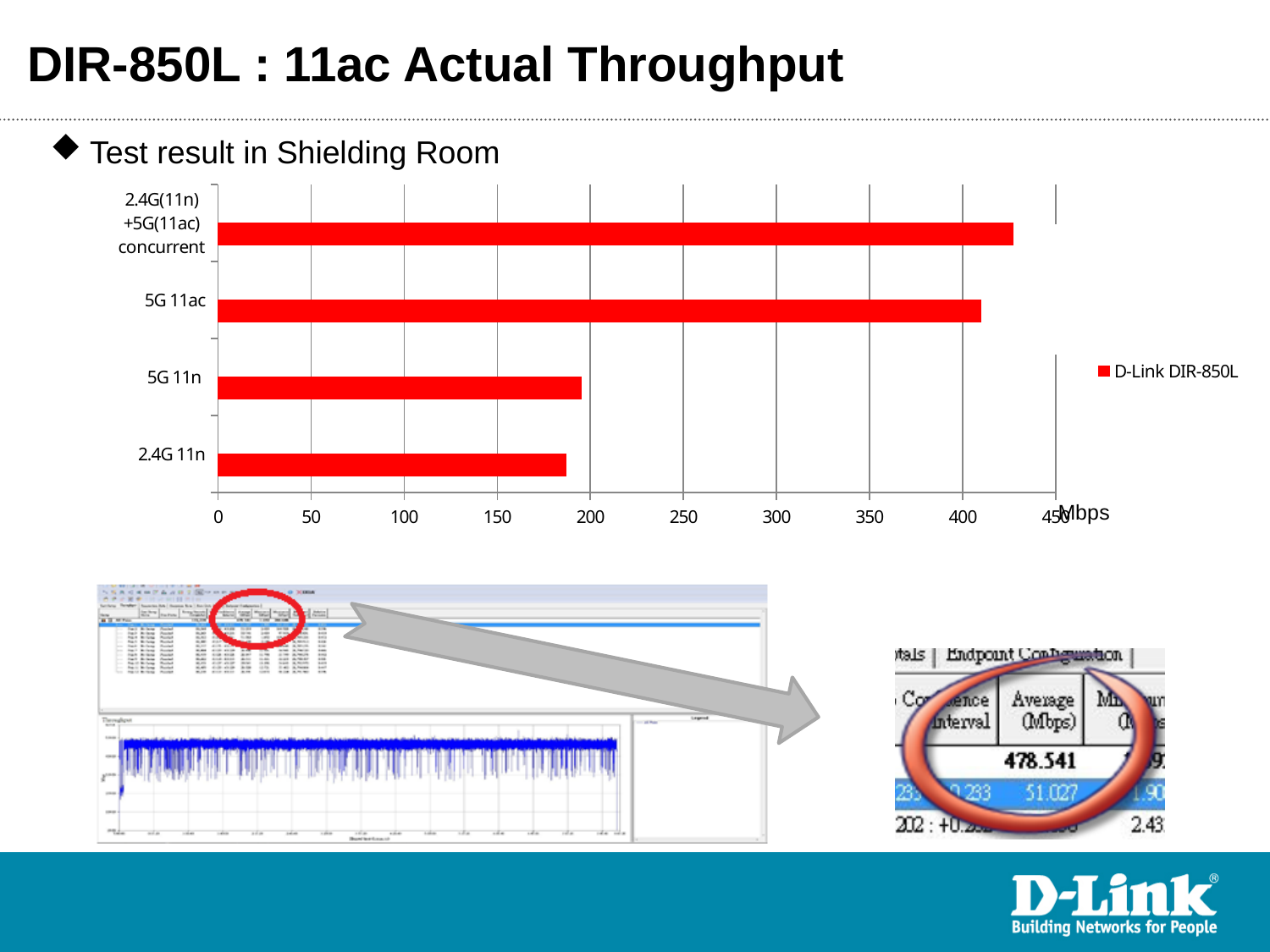
How many categories are plotted in the bar chart? 4 Is the value for 2.4G 11n greater or less than 150? greater Is the value for 5G 11n greater or less than 200? less Which is larger, the value for 5G 11ac or the value for 5G 11n? 5G 11ac Is the value for 5G 11ac greater or less than 400? greater What unit is shown at the end of the horizontal axis? Mbps How many series does the chart legend list? 1 What series name is shown in the chart legend? D-Link DIR-850L Which is larger, the value for 2.4G 11n or the value for 5G 11ac? 5G 11ac What kind of chart is shown on the slide? bar chart Which category has the highest throughput in the chart? 2.4G(11n)+5G(11ac) concurrent